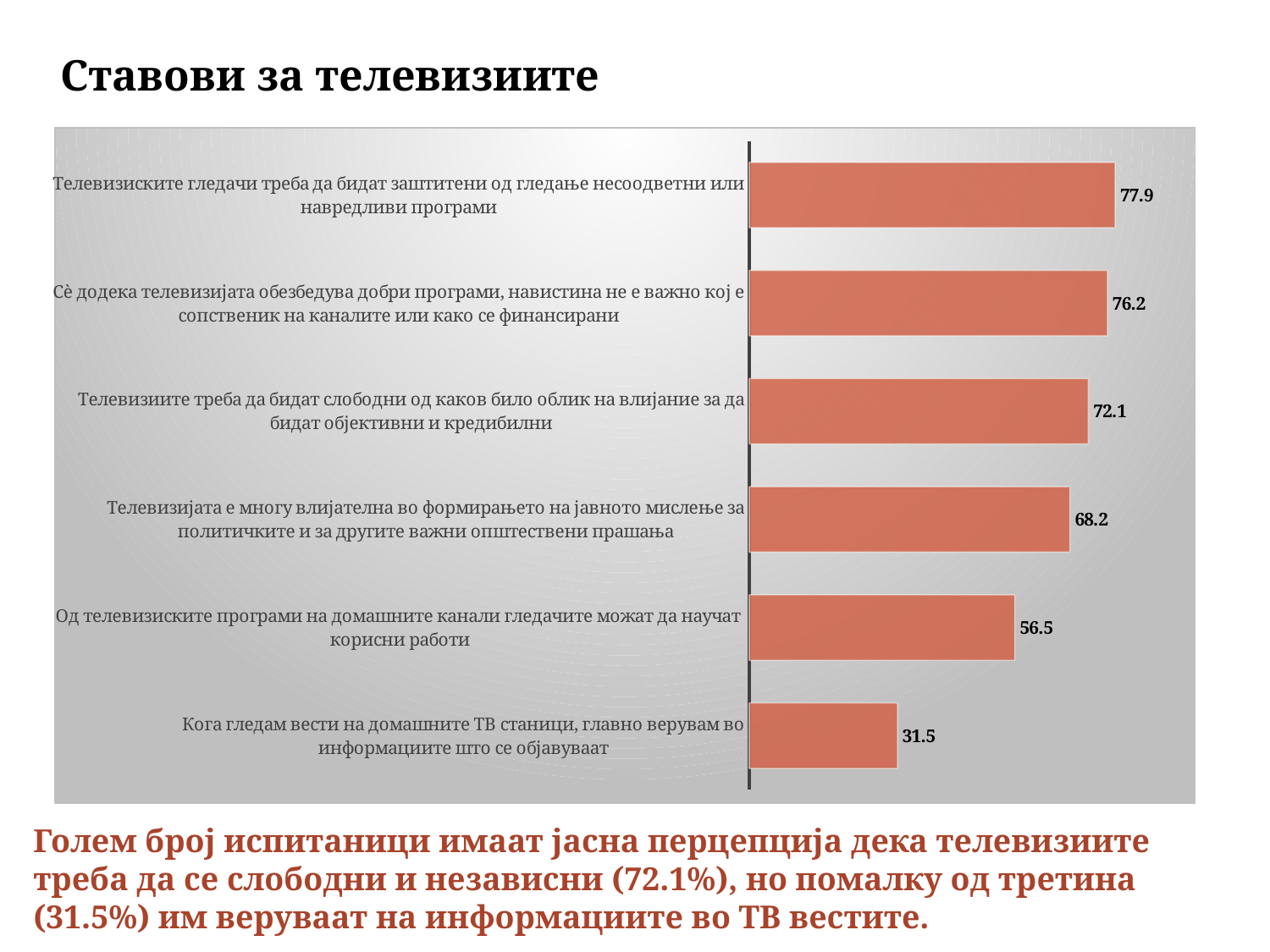
What is the difference between the highest value (77.9) and the lowest value (31.5) in the chart? 46.4 Which is larger: the value for "Од телевизиските програми на домашните канали гледачите можат да научат корисни работи" or the value for "Кога гледам вести на домашните ТВ станици, главно верувам во информациите што се објавуваат"? Од телевизиските програми на домашните канали гледачите можат да научат корисни работи What type of chart is shown on the slide? Bar chart Which statement has the lowest value in the chart? Кога гледам вести на домашните ТВ станици, главно верувам во информациите што се објавуваат How many statements (bars) are shown in the chart? 6 What is the value for the statement "Телевизијата е многу влијателна во формирањето на јавното мислење за политичките и за другите важни општествени прашања"? 68.2 What is the value for the statement "Кога гледам вести на домашните ТВ станици, главно верувам во информациите што се објавуваат"? 31.5 What is the difference between the values for "Телевизиите треба да бидат слободни од каков било облик на влијание за да бидат објективни и кредибилни" (72.1) and "Телевизијата е многу влијателна во формирањето на јавното мислење..." (68.2)? 3.9 What is the title of the slide containing the chart? Ставови за телевизиите What is the value for the statement "Телевизиските гледачи треба да бидат заштитени од гледање несоодветни или навредливи програми"? 77.9 What is the value for the statement "Од телевизиските програми на домашните канали гледачите можат да научат корисни работи"? 56.5 Which statement has the highest value in the chart? Телевизиските гледачи треба да бидат заштитени од гледање несоодветни или навредливи програми